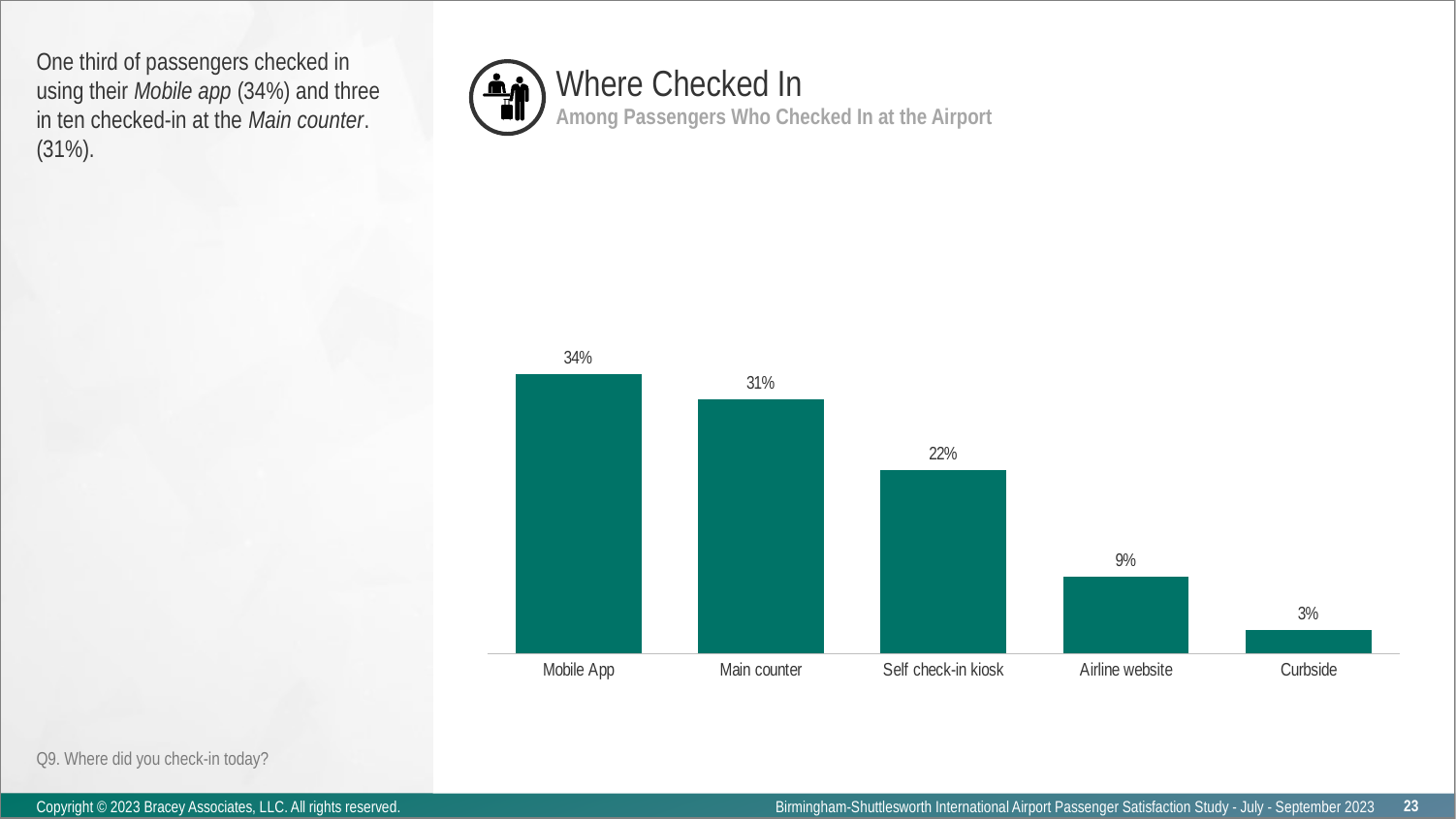
What is the title of the chart? Where Checked In What is the difference between the Self check-in kiosk and Airline website percentages? 13% Which is larger, the value for Main counter or the value for Airline website? Main counter Which check-in location has the highest percentage? Mobile App What is the value shown for Self check-in kiosk? 22% What is the difference between the Mobile App and Main counter percentages? 3% What percentage of passengers checked in at Curbside? 3% What kind of chart is shown on the slide? Bar chart How many check-in locations are shown in the chart? 5 Do the values rise or fall moving from left to right across the categories? Fall Which check-in location has the lowest percentage? Curbside What percentage of passengers checked in using the Mobile App? 34%